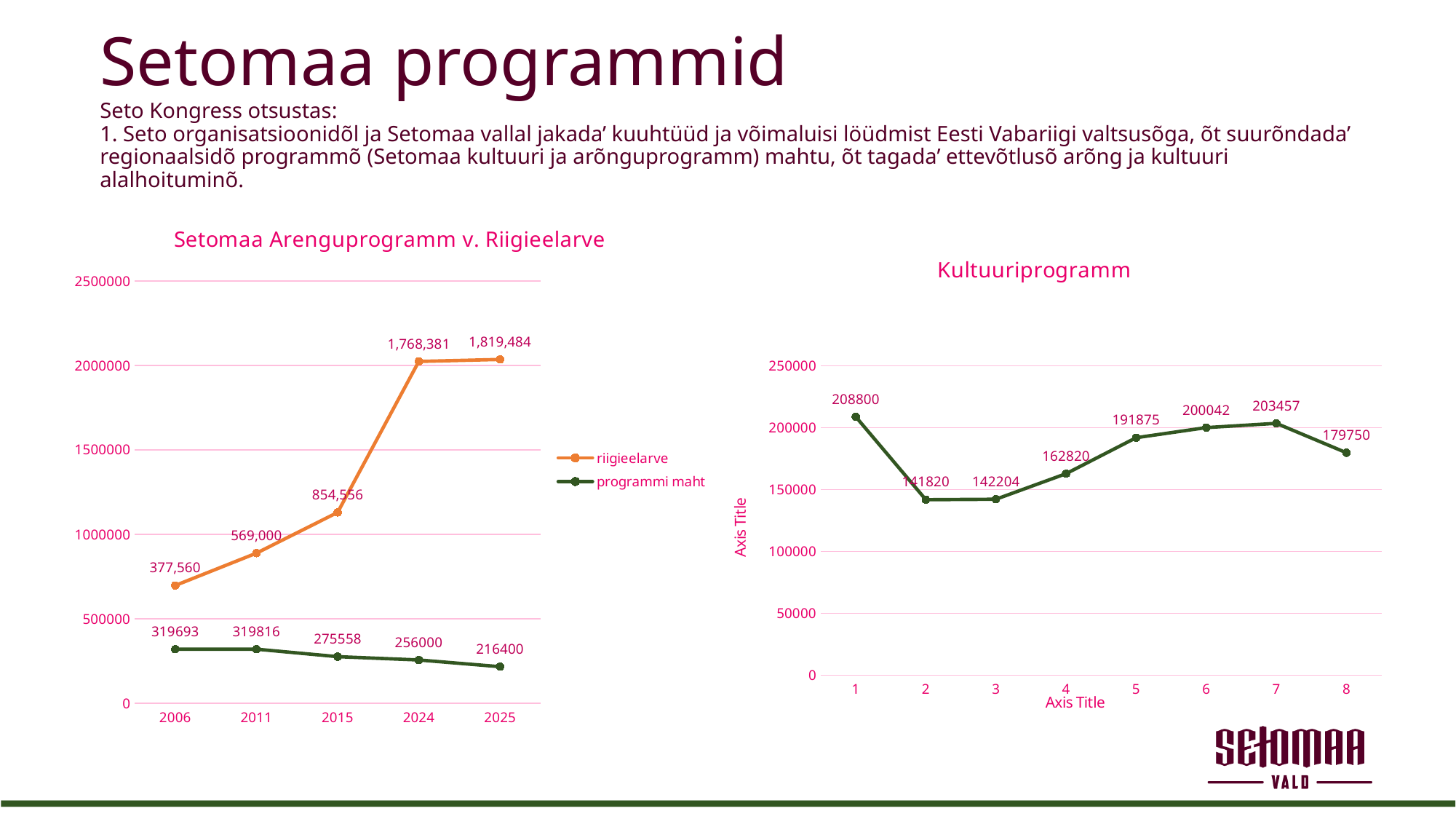
In the 'Setomaa Arenguprogramm v. Riigieelarve' chart, what is the riigieelarve value for 2015? 854,556 In the 'Setomaa Arenguprogramm v. Riigieelarve' chart, which year has the lowest programmi maht value? 2025 In the 'Setomaa Arenguprogramm v. Riigieelarve' chart, what is the difference between the riigieelarve values for 2025 and 2024? 51,103 In the 'Kultuuriprogramm' chart, what is the value at point 5? 191875 How many years are shown on the x axis of the 'Setomaa Arenguprogramm v. Riigieelarve' chart? 5 In the 'Setomaa Arenguprogramm v. Riigieelarve' chart, which year has the highest riigieelarve value? 2025 How many series does the legend of the 'Setomaa Arenguprogramm v. Riigieelarve' chart list? 2 In the 'Setomaa Arenguprogramm v. Riigieelarve' chart, does the programmi maht series rise or fall from 2011 to 2025? fall What kind of chart is the 'Kultuuriprogramm' chart? line chart In the 'Kultuuriprogramm' chart, which point has the highest value? 1 In the 'Setomaa Arenguprogramm v. Riigieelarve' chart, what is the programmi maht value for 2025? 216400 How many data points are plotted in the 'Kultuuriprogramm' chart? 8